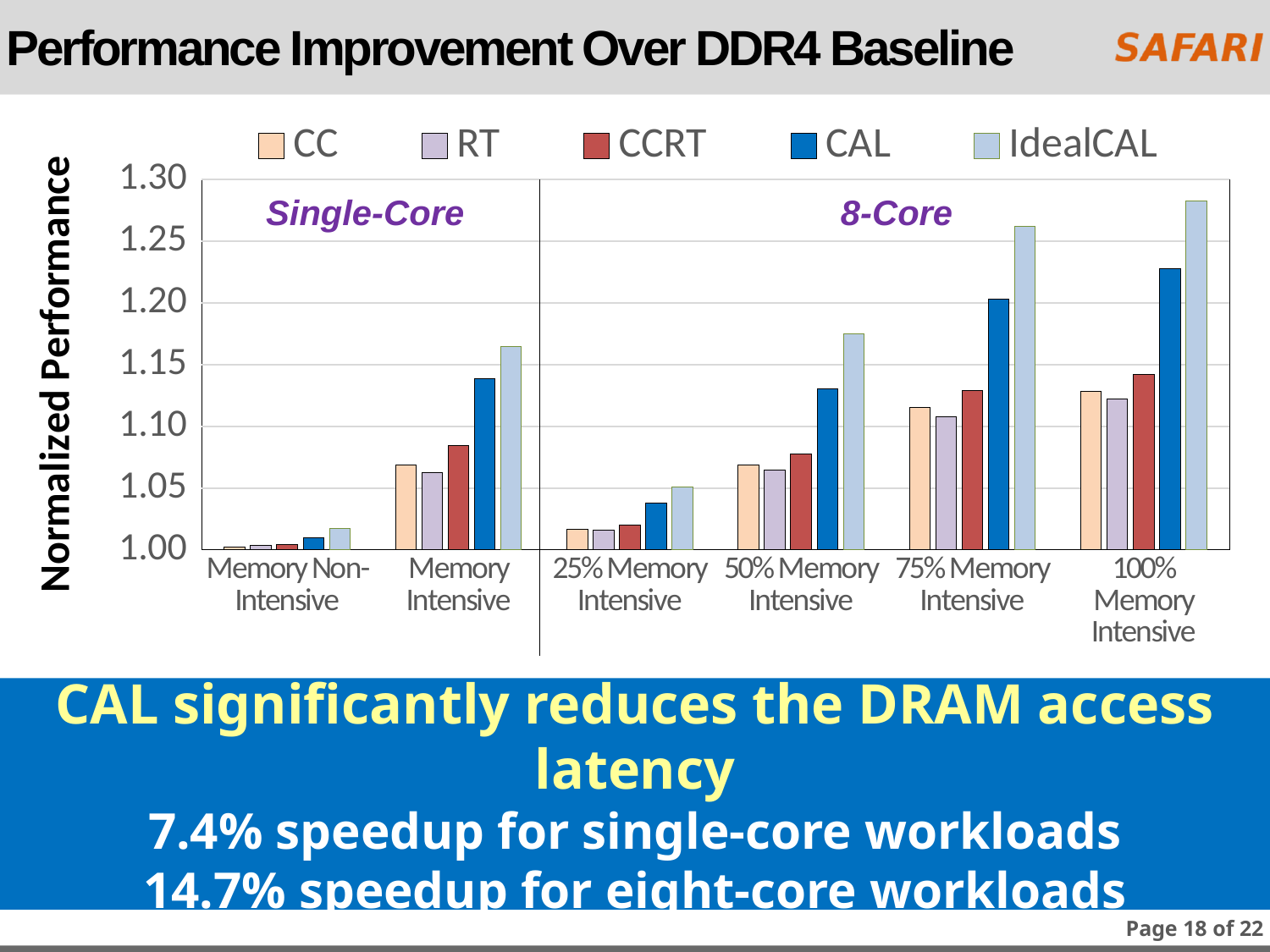
For 75% Memory Intensive, which is larger, the CAL value or the CCRT value? CAL How many series does the legend list? 5 What is the title of the y axis? Normalized Performance Is the CAL value for 100% Memory Intensive greater or less than 1.20? greater Across the 8-Core categories from 25% to 100% Memory Intensive, do the CAL values rise or fall? rise Is the CAL value for 25% Memory Intensive greater or less than 1.05? less Is the IdealCAL value for 50% Memory Intensive greater or less than 1.15? greater Which category has the highest IdealCAL value? 100% Memory Intensive How many workload categories are shown along the x axis? 6 Which category has the lowest CAL value? Memory Non-Intensive What kind of chart is shown on the slide? bar chart